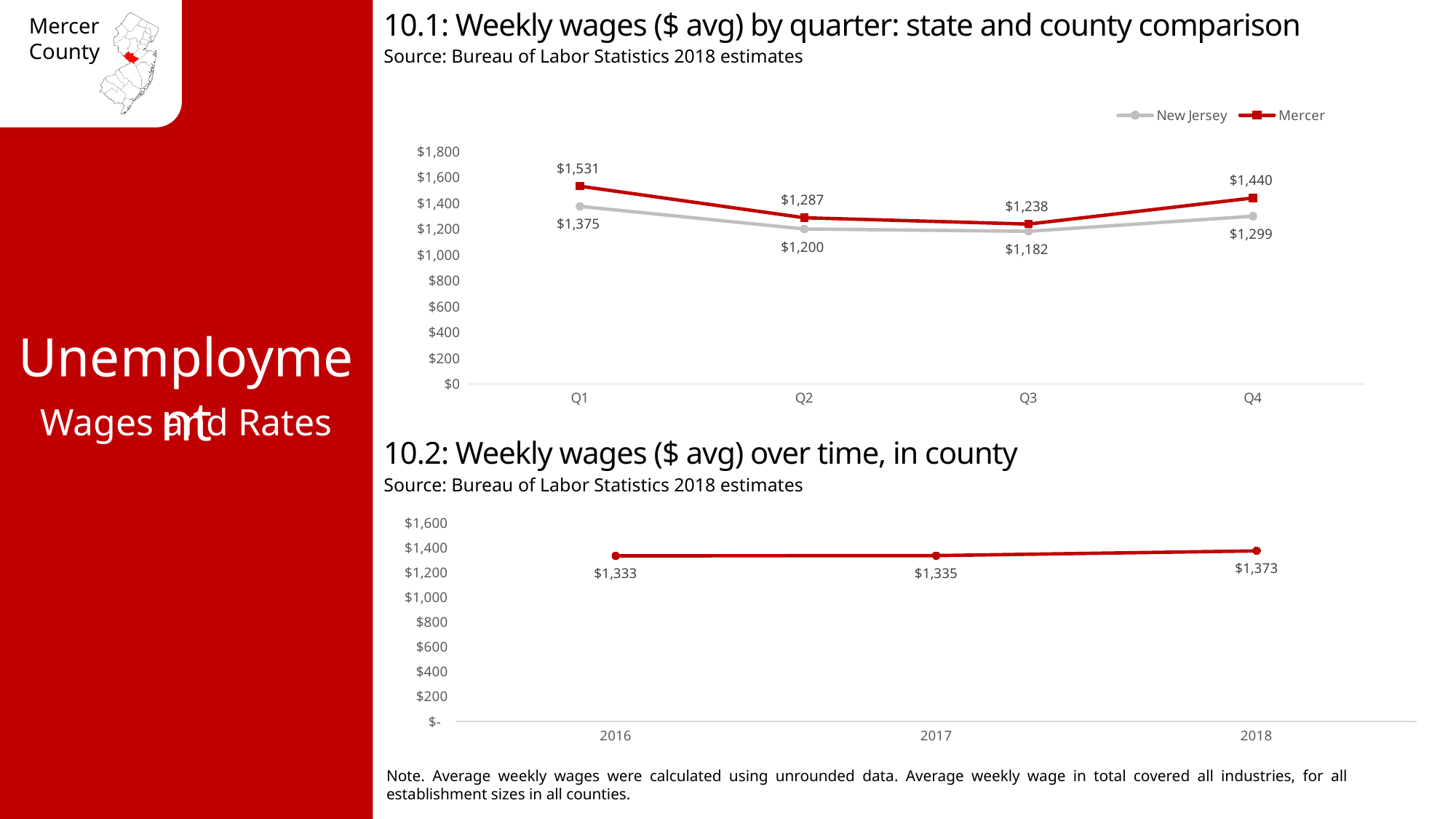
In chart 10.1 (Weekly wages by quarter: state and county comparison), what is the New Jersey value for Q3? $1,182 In chart 10.1 (Weekly wages by quarter: state and county comparison), in which quarter is the New Jersey value highest? Q1 In chart 10.2 (Weekly wages over time, in county), how many years are plotted? 3 In chart 10.1 (Weekly wages by quarter: state and county comparison), what kind of chart is shown? Line chart In chart 10.1 (Weekly wages by quarter: state and county comparison), how many series does the legend list? 2 In chart 10.1 (Weekly wages by quarter: state and county comparison), in which quarter is the Mercer value lowest? Q3 In chart 10.2 (Weekly wages over time, in county), what is the difference between the 2018 and 2016 values? $40 In chart 10.1 (Weekly wages by quarter: state and county comparison), what is the Mercer value for Q1? $1,531 In chart 10.1 (Weekly wages by quarter: state and county comparison), which series has the higher value in Q2, New Jersey or Mercer? Mercer In chart 10.2 (Weekly wages over time, in county), what is the value for 2018? $1,373 In chart 10.2 (Weekly wages over time, in county), do the values rise or fall from 2016 to 2018? Rise In chart 10.1 (Weekly wages by quarter: state and county comparison), what is the difference between the Mercer and New Jersey values in Q4? $141